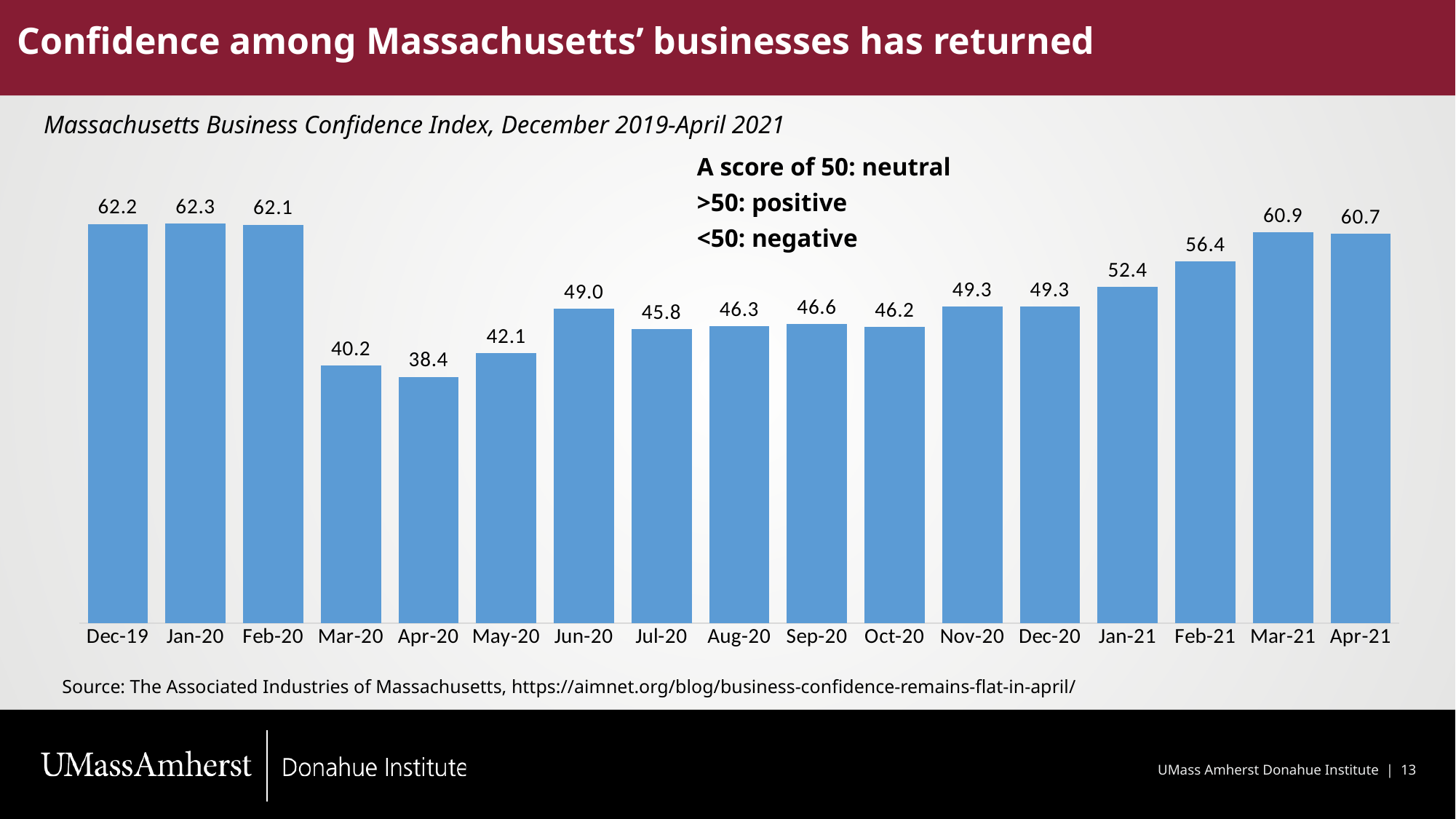
Which month has the lowest index value? Apr-20 Do the index values rise or fall from Apr-20 to Jun-20? Rise How many months are shown on the chart? 17 What is the index value for Jun-20? 49.0 According to the note on the chart, what score is considered neutral? 50 What is the Massachusetts Business Confidence Index value for Apr-20? 38.4 What kind of chart is shown on the slide? Bar chart Which is larger, the index value for Sep-20 or Oct-20? Sep-20 Which month has the highest index value? Jan-20 What is the index value for Feb-21? 56.4 What is the difference between the index values for Mar-21 and Feb-21? 4.5 What is the difference between the index values for Feb-20 and Mar-20? 21.9